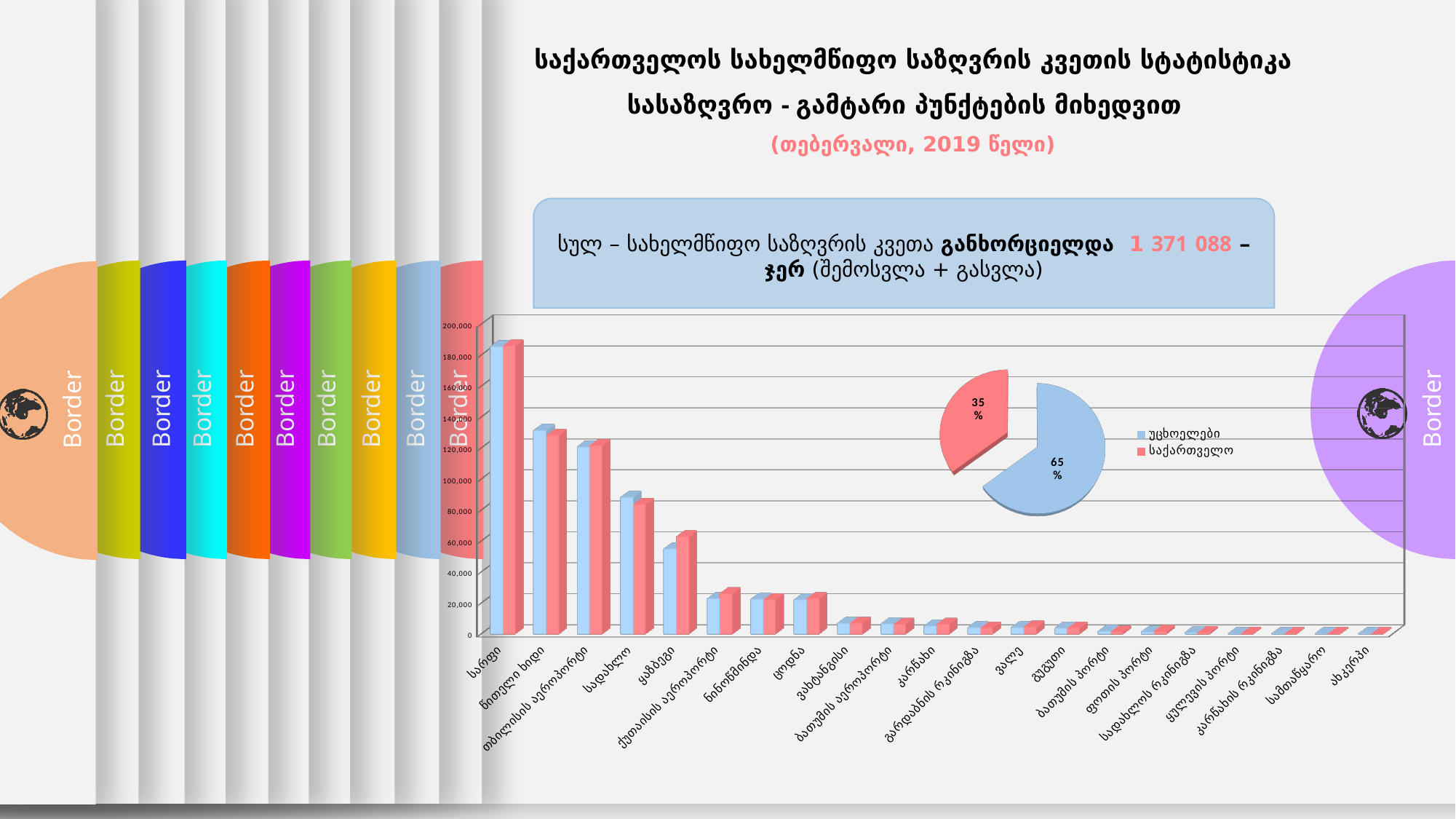
In the pie chart, what share is shown for საქართველო? 35% In the bar chart, are the values for სარფი greater or less than 160,000? greater In the pie chart, what is the difference between the უცხოელები share and the საქართველო share? 30% In the bar chart, how many categories are shown on the x axis? 21 In the bar chart, are the values for ყაზბეგი greater or less than 80,000? less In the pie chart, what share is shown for უცხოელები? 65% In the bar chart, are the values for თბილისის აეროპორტი greater or less than 100,000? greater In the bar chart, do the values rise or fall moving from left to right along the x axis? Fall How many entries does the legend of the pie chart list? 2 What kind of chart is the large chart at the bottom of the slide? Bar chart In the bar chart, which category has the highest values? სარფი In the pie chart, which slice is larger, უცხოელები or საქართველო? უცხოელები